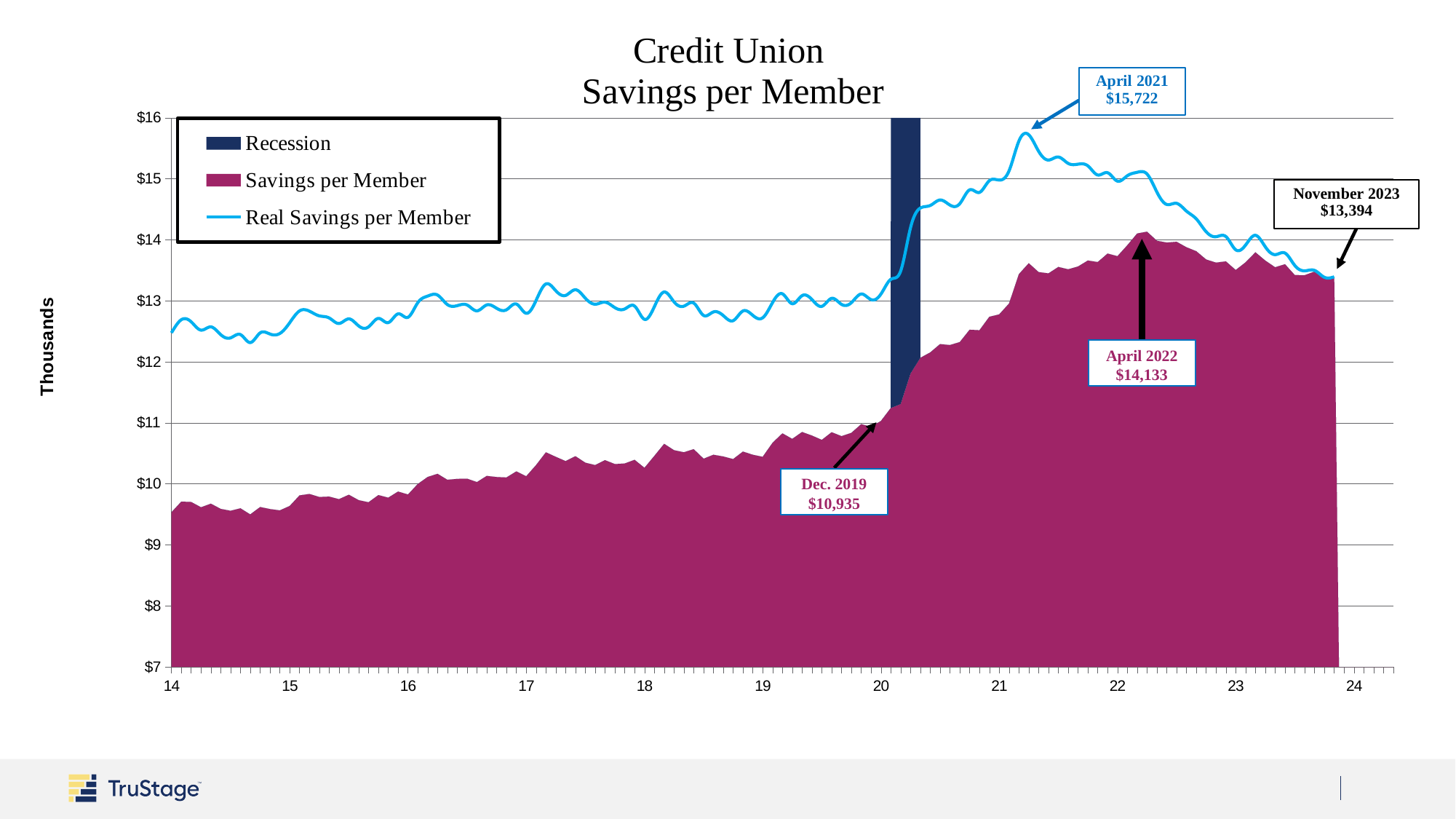
What is the difference between the annotated April 2022 value and the annotated Dec. 2019 value? $3,198 How many entries does the legend list? 3 Is the Real Savings per Member value at the start of 2016 greater or less than $12? greater What value is annotated for November 2023? $13,394 What value is annotated for April 2021 on the Real Savings per Member line? $15,722 What is the difference between the annotated April 2021 value and the annotated November 2023 value? $2,328 What value is annotated for April 2022 on the Savings per Member series? $14,133 What unit label is shown on the vertical axis? Thousands Does Savings per Member rise or fall from 2014 to 2022? rise Is the Savings per Member value at the start of 2014 greater or less than $10? less Which annotated value is larger: April 2022 or Dec. 2019? April 2022 What was Savings per Member in Dec. 2019, according to the annotation? $10,935